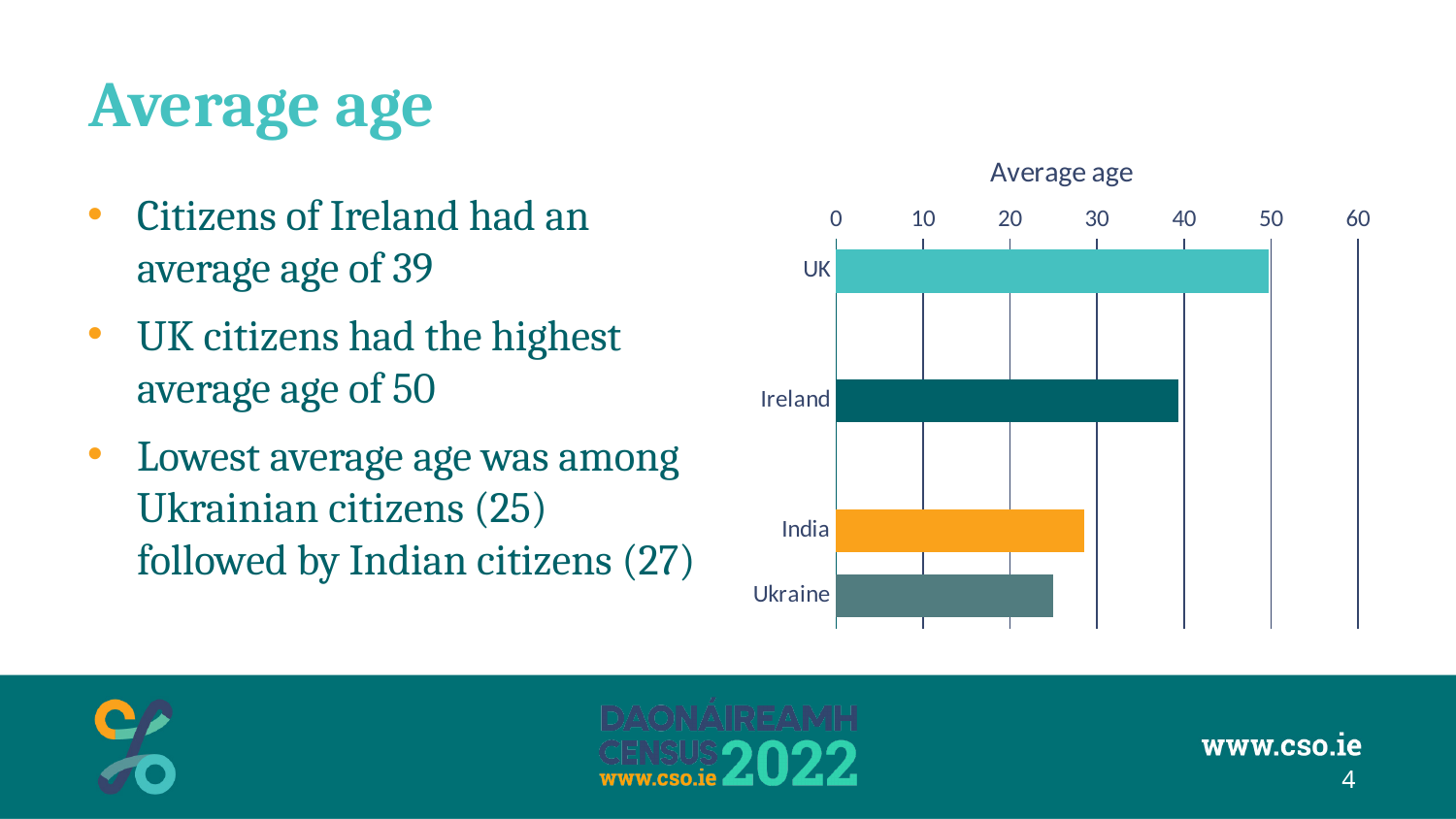
What is the average age for Ukrainian citizens? 25 What is the title of the chart? Average age Which has a higher average age, Ireland or India? Ireland What is the average age for citizens of Ireland? 39 What is the difference between the average age of UK citizens and Ukrainian citizens? 25 Is the average age for India greater or less than 30? less What is the average age for UK citizens? 50 How many countries are shown in the chart? 4 What type of chart is shown on the slide? bar chart Is the average age for Ireland greater or less than 30? greater Which country has the lowest average age in the chart? Ukraine Which country has the highest average age in the chart? UK